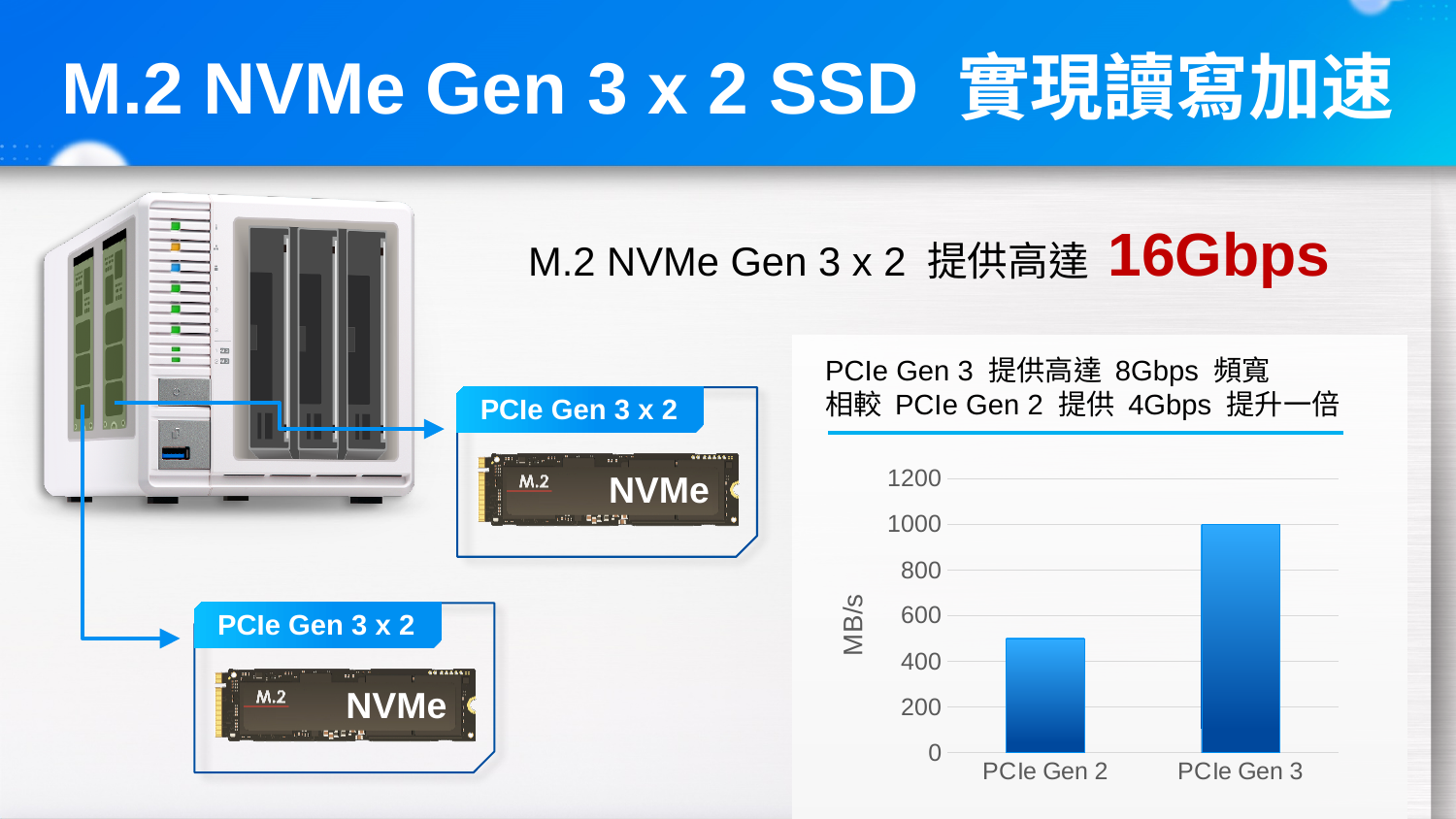
What unit is shown on the y axis of the chart? MB/s What kind of chart is shown on the slide? bar chart Which category has the lowest value in the chart? PCIe Gen 2 What is the highest tick value shown on the y axis of the chart? 1200 How many categories are plotted on the x axis of the chart? 2 Is the value for PCIe Gen 2 greater or less than 400? greater Which is larger in the chart, the value for PCIe Gen 2 or PCIe Gen 3? PCIe Gen 3 What value does the bar for PCIe Gen 3 reach on the y axis? 1000 Is the value for PCIe Gen 2 greater or less than 600? less Which category has the highest value in the chart? PCIe Gen 3 Do the values rise or fall from PCIe Gen 2 to PCIe Gen 3 along the x axis? rise Is the value for PCIe Gen 3 greater or less than 800? greater